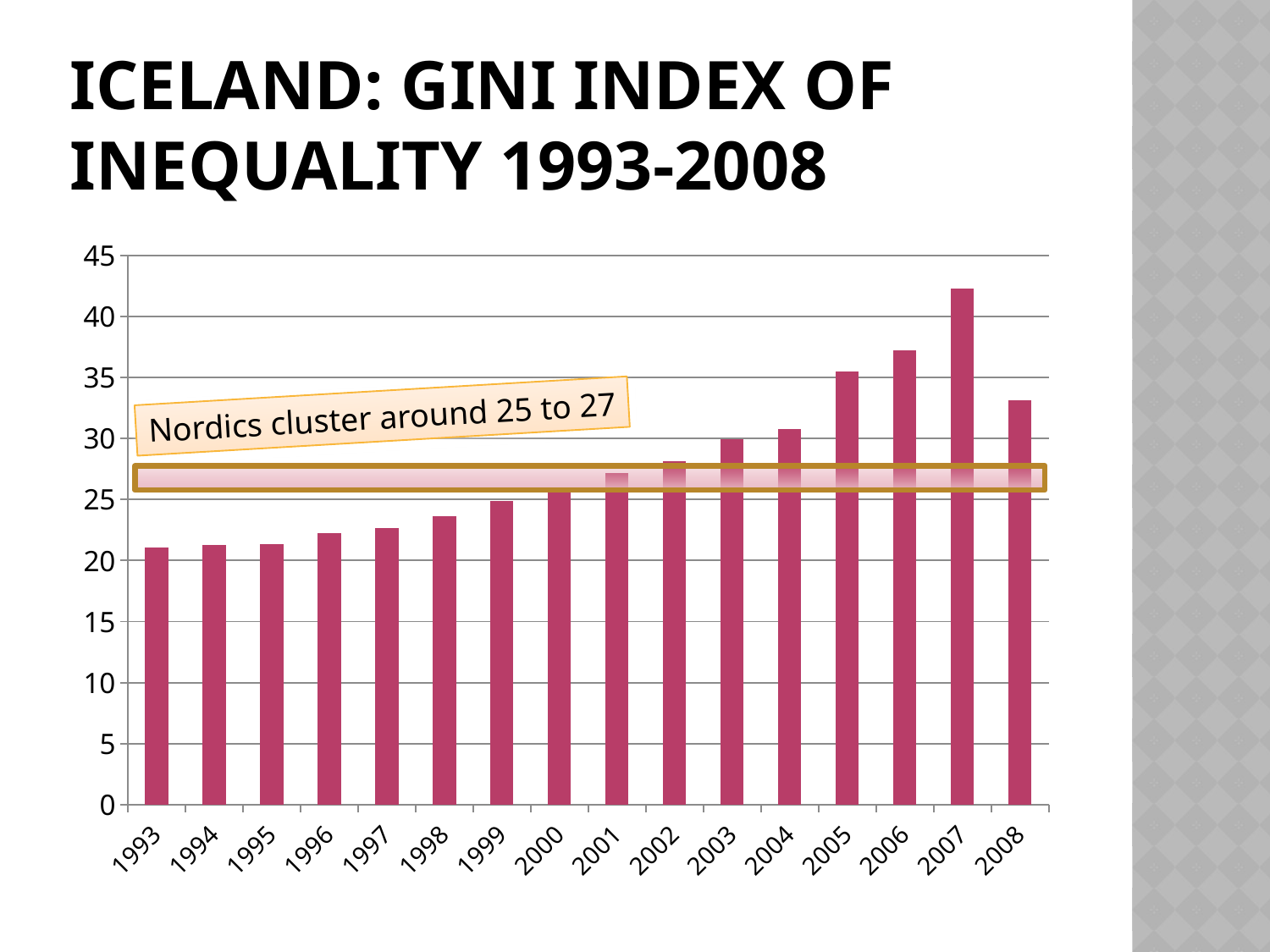
Which year has the highest Gini index value? 2007 Which is larger, the value for 1993 or the value for 2000? 2000 Which is larger, the value for 2007 or the value for 2008? 2007 Is the value for 2008 greater or less than 30? greater Is the value for 2007 greater or less than 40? greater Is the value for 1993 greater or less than 25? less What kind of chart is shown on the slide? Bar chart How many years are plotted on the x axis? 16 Do the values generally rise or fall from 1993 to 2007? rise What does the annotation box on the chart say? Nordics cluster around 25 to 27